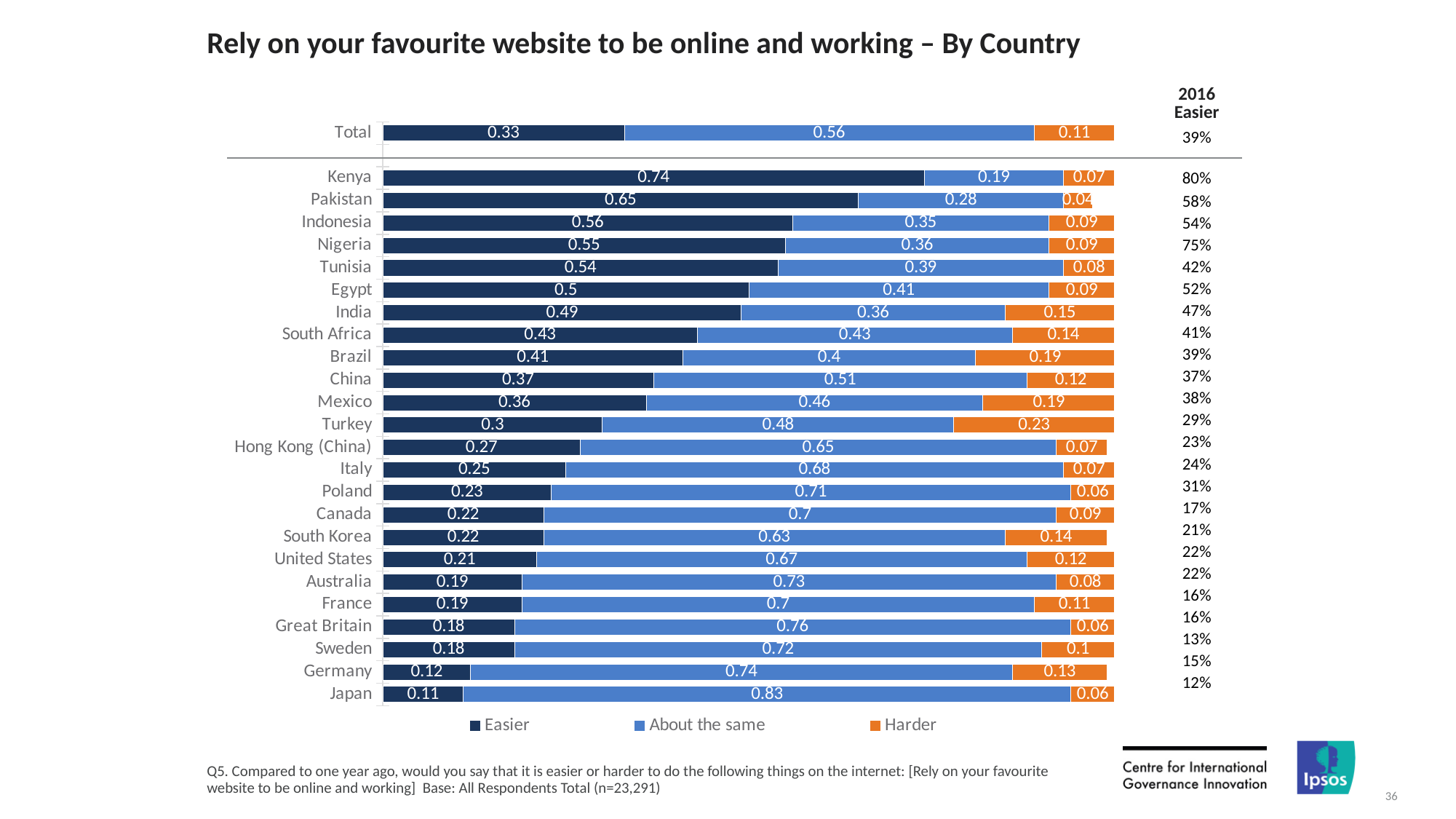
What is the About the same value for Brazil? 0.4 What is the Easier value for Total? 0.33 What is the Harder value for Germany? 0.13 Which country has the lowest Easier value? Japan Which has a larger Easier value, Indonesia or Mexico? Indonesia How many series does the legend list? 3 Which country has the highest Easier value? Kenya Which country has the highest Harder value? Turkey How many countries (excluding Total) are shown in the chart? 24 What kind of chart is shown on the slide? Stacked bar chart Going from top to bottom of the country list, do the Easier values increase or decrease? Decrease What is the difference between the Easier values for Kenya and Japan? 0.63